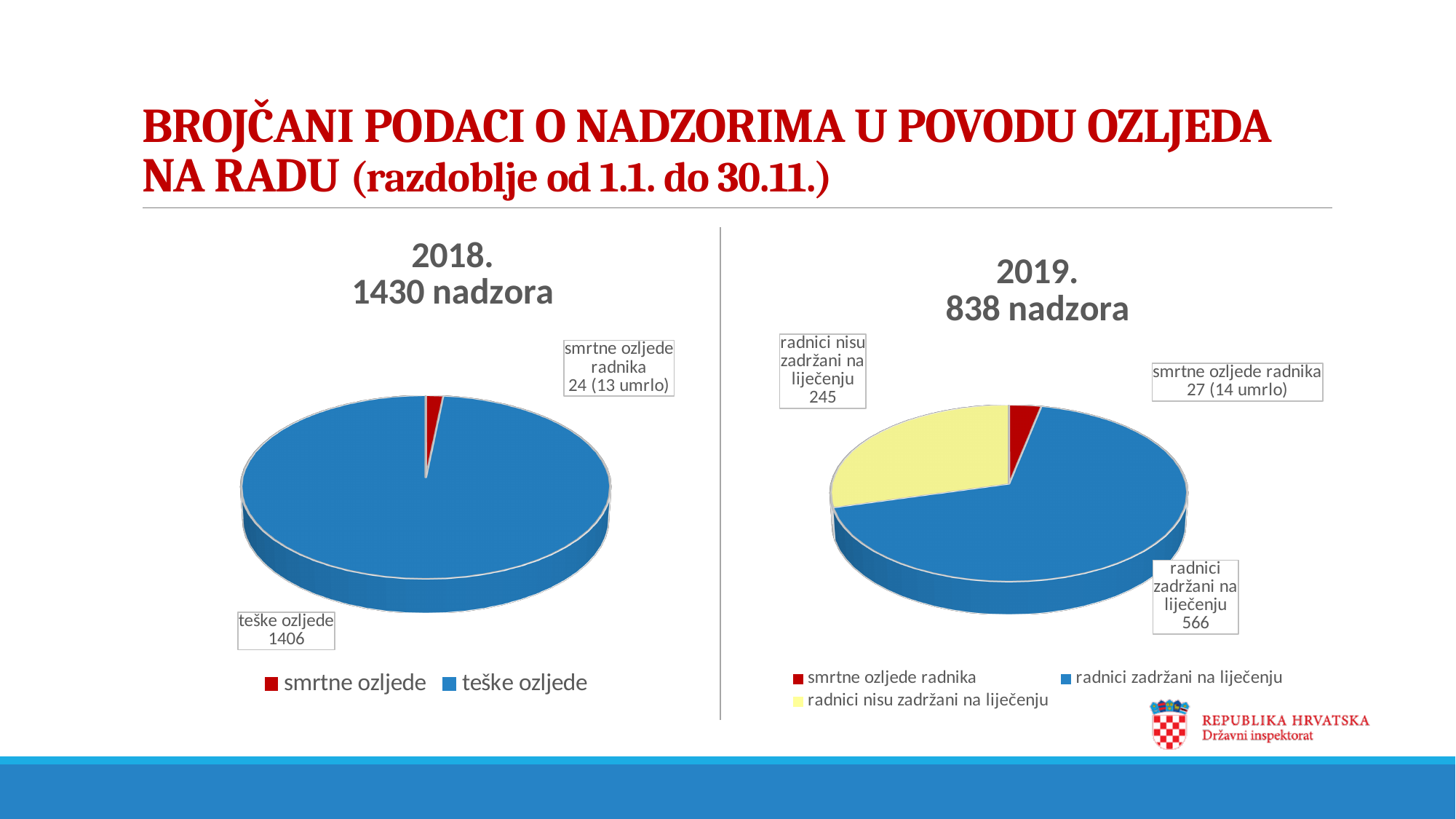
How many slices does the 2019 chart have? 3 In the 2019 chart, what is the value for radnici zadržani na liječenju? 566 In the 2018 chart, what is the value for teške ozljede? 1406 In the 2018 chart, which is larger: smrtne ozljede or teške ozljede? teške ozljede In the 2019 chart, which category has the largest slice? radnici zadržani na liječenju In the 2019 chart, which category has the smallest slice? smrtne ozljede radnika How many entries does the legend of the 2018 chart list? 2 In the 2019 chart, what is the value for radnici nisu zadržani na liječenju? 245 In the 2019 chart, what is the data label for smrtne ozljede radnika? 27 (14 umrlo) In the 2018 chart, what is the data label for smrtne ozljede radnika? 24 (13 umrlo) What type of chart is used for the 2018 data? pie chart In the 2019 chart, what is the difference between radnici zadržani na liječenju and radnici nisu zadržani na liječenju? 321